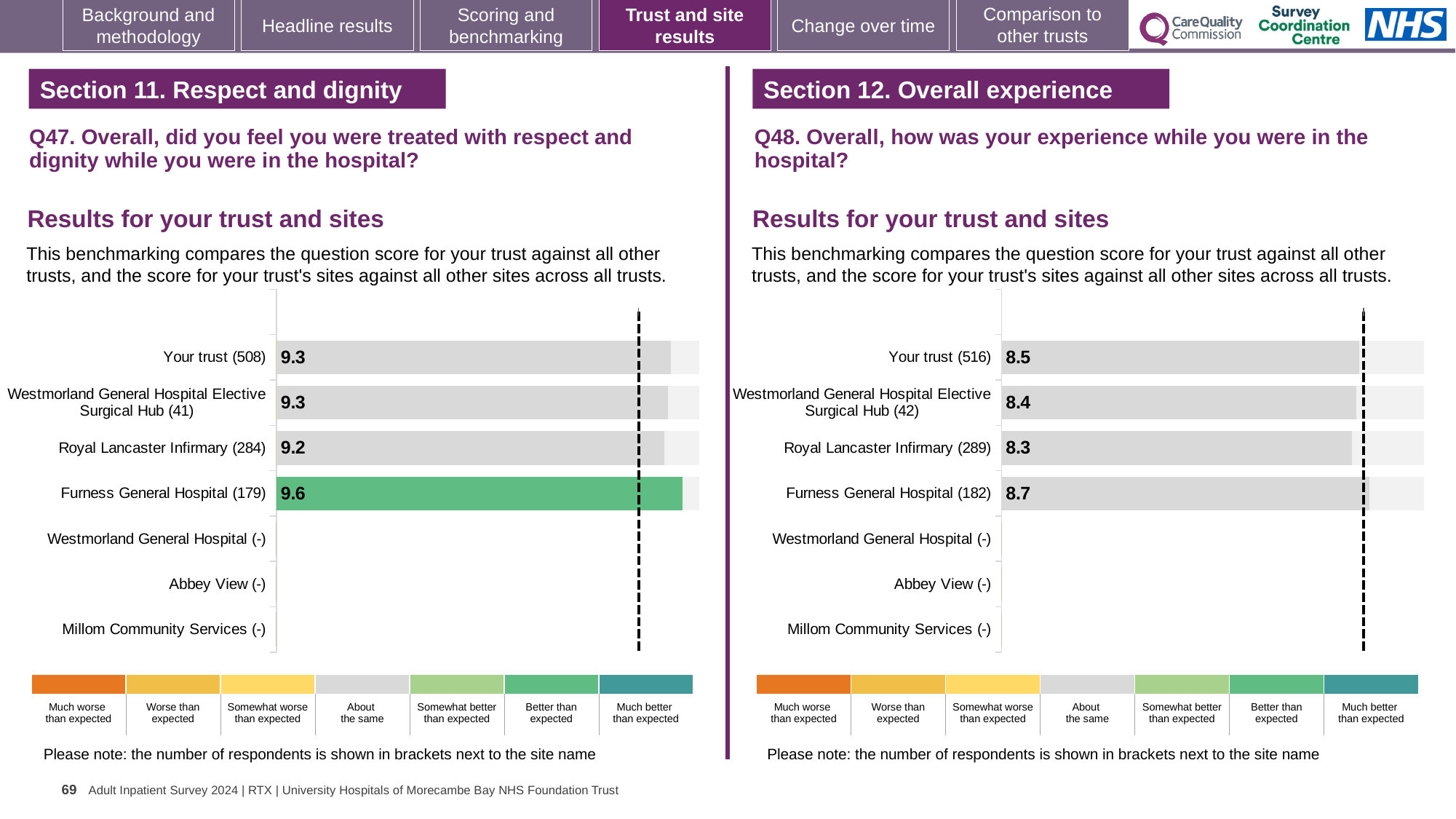
On the Q47 chart (left), how many bars have a score plotted? 4 On the Q48 chart (right), which is larger, the score for Westmorland General Hospital Elective Surgical Hub or for Royal Lancaster Infirmary? Westmorland General Hospital Elective Surgical Hub On the Q47 chart (left), which site has the lowest score among those with a score shown? Royal Lancaster Infirmary On the Q47 chart (left), which site has the highest score? Furness General Hospital On the Q47 chart (left), what is the difference between the scores for Furness General Hospital and Royal Lancaster Infirmary? 0.4 What kind of chart is used on the Q47 chart (left)? Bar chart On the Q48 chart (right), what is the score for Your trust? 8.5 On the Q47 chart (left), what is the score for Your trust? 9.3 On the Q48 chart (right), what is the difference between the scores for Furness General Hospital and Your trust? 0.2 On the Q48 chart (right), which site has the highest score? Furness General Hospital On the Q47 chart (left), what is the score for Furness General Hospital? 9.6 On the Q48 chart (right), what is the score for Royal Lancaster Infirmary? 8.3